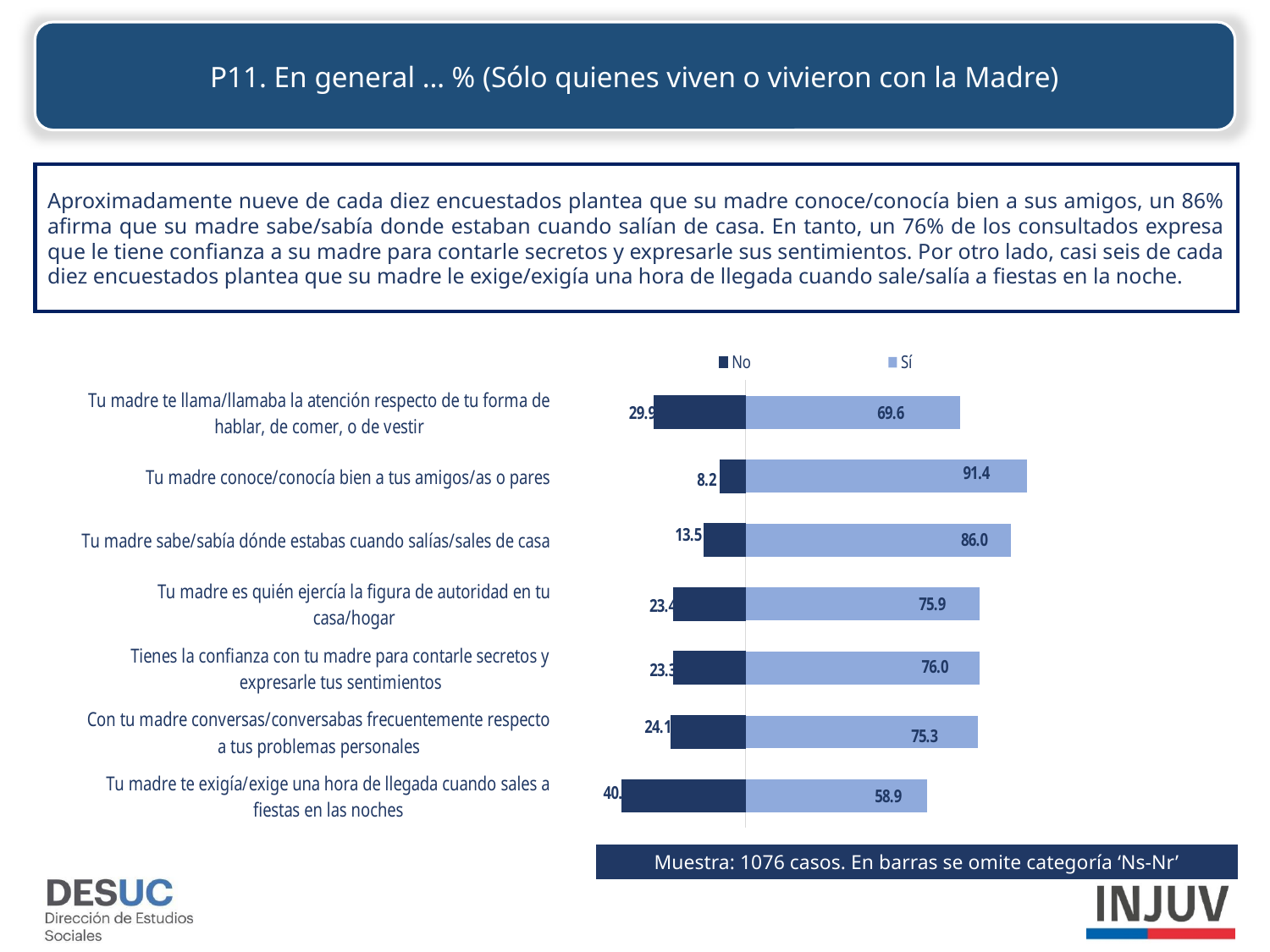
What is the 'Sí' value for 'Tu madre te exigía/exige una hora de llegada cuando sales a fiestas en las noches'? 58.9 What is the 'No' value for 'Tu madre sabe/sabía dónde estabas cuando salías/sales de casa'? 13.5 What is the difference between the 'Sí' values for 'Tu madre conoce/conocía bien a tus amigos/as o pares' and 'Tu madre sabe/sabía dónde estabas cuando salías/sales de casa'? 5.4 What are the two series named in the chart legend? No and Sí Which statement has the lowest 'No' value? Tu madre conoce/conocía bien a tus amigos/as o pares Which statement has the highest 'Sí' value? Tu madre conoce/conocía bien a tus amigos/as o pares How many statements (categories) are plotted in the chart? 7 What kind of chart is shown on the slide? bar chart Which is larger: the 'No' value for 'Tu madre te llama/llamaba la atención respecto de tu forma de hablar, de comer, o de vestir' or the 'No' value for 'Tu madre es quién ejercía la figura de autoridad en tu casa/hogar'? Tu madre te llama/llamaba la atención respecto de tu forma de hablar, de comer, o de vestir How many series does the chart legend list? 2 Which statement has the lowest 'Sí' value? Tu madre te exigía/exige una hora de llegada cuando sales a fiestas en las noches What is the 'Sí' value for 'Tu madre conoce/conocía bien a tus amigos/as o pares'? 91.4